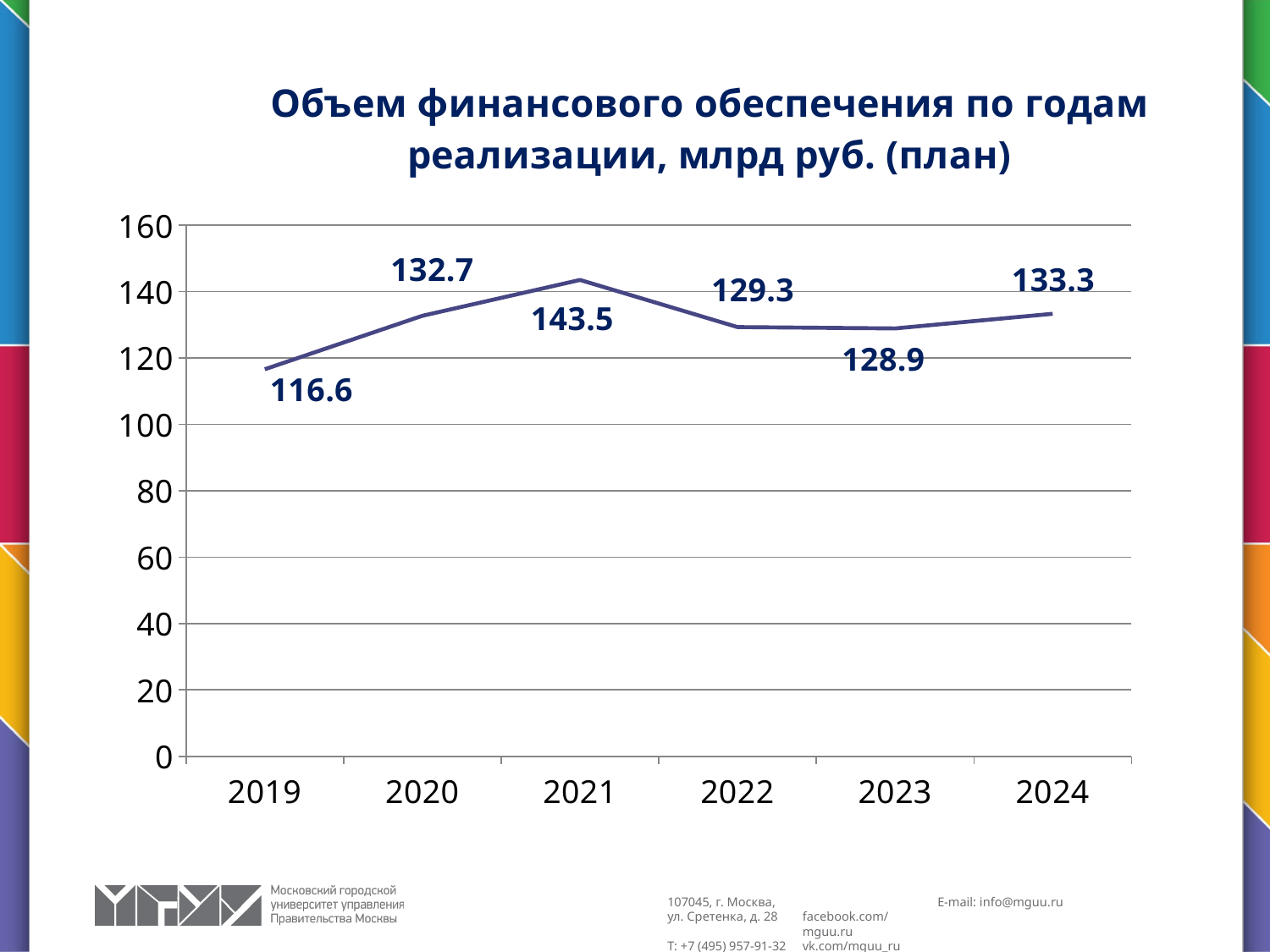
Do the values rise or fall from 2019 to 2021? rise How many years are plotted on the chart? 6 What is the difference between the values for 2021 and 2019? 26.9 What is the value for 2021? 143.5 What is the value for 2024? 133.3 Which is larger, the value for 2020 or the value for 2022? 2020 Is the value for 2021 greater or less than 140? greater Which year has the highest value? 2021 Which year has the lowest value? 2019 What kind of chart is shown on the slide? line chart What is the difference between the values for 2024 and 2023? 4.4 What is the value for 2019? 116.6